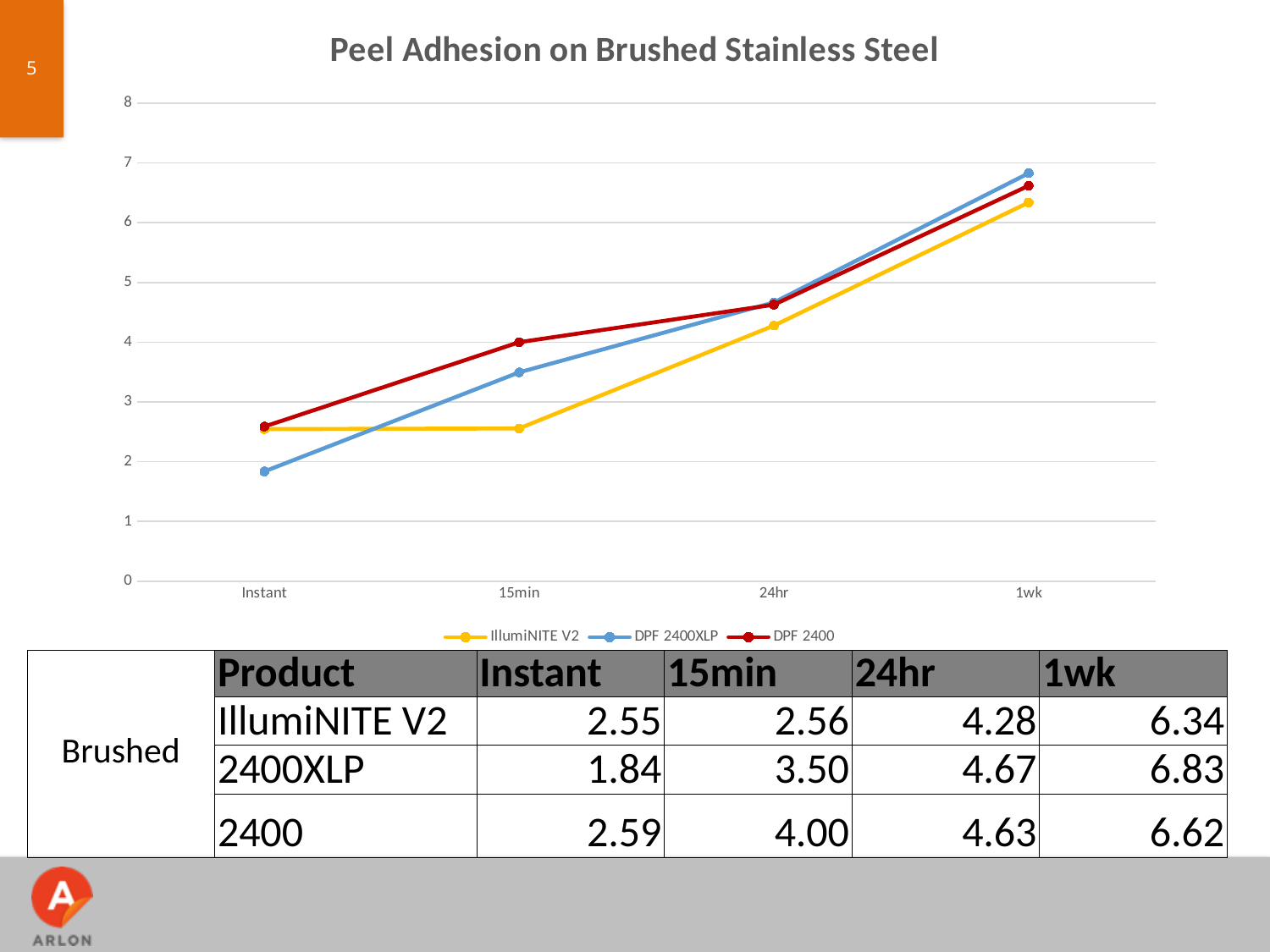
Which is larger at 15min: the value for DPF 2400XLP or the value for IllumiNITE V2? DPF 2400XLP Which series has the highest value at 15min? DPF 2400 What is the difference between the 1wk values of DPF 2400XLP and IllumiNITE V2? 0.49 How many time points are plotted along the x axis? 4 What is the peel adhesion value for DPF 2400 at 15min? 4.00 Which series has the lowest value at Instant? DPF 2400XLP What is the peel adhesion value for IllumiNITE V2 at 24hr? 4.28 How many series does the chart legend list? 3 What is the peel adhesion value for DPF 2400XLP at 1wk? 6.83 What is the title of the chart? Peel Adhesion on Brushed Stainless Steel Does the value for IllumiNITE V2 rise or fall from Instant to 1wk? rise What type of chart is shown on the slide? line chart